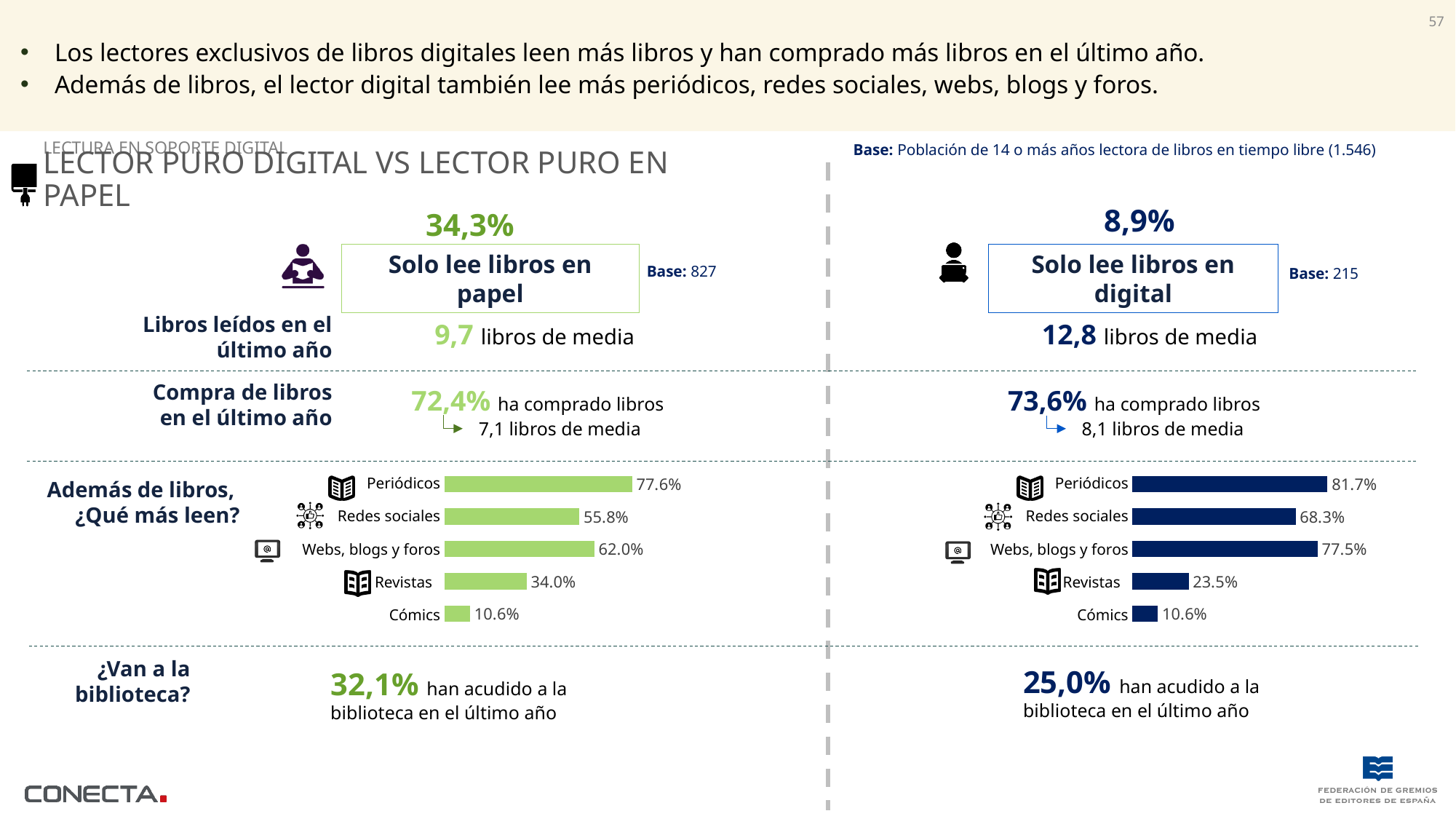
In the left-hand bar chart (Solo lee libros en papel), which category has the lowest value? Cómics In the left-hand bar chart (Solo lee libros en papel), what is the value for Revistas? 34.0% In the right-hand bar chart (Solo lee libros en digital), what is the value for Redes sociales? 68.3% In the left-hand bar chart (Solo lee libros en papel), what is the value for Periódicos? 77.6% Which is larger: Redes sociales in the left-hand chart (papel) or Redes sociales in the right-hand chart (digital)? Right-hand chart (digital) In the left-hand bar chart (Solo lee libros en papel), which is larger: Webs, blogs y foros or Redes sociales? Webs, blogs y foros In the left-hand bar chart (Solo lee libros en papel), what is the difference between Periódicos and Redes sociales? 21.8% In the right-hand bar chart (Solo lee libros en digital), what is the difference between Webs, blogs y foros and Revistas? 54.0% In the right-hand bar chart (Solo lee libros en digital), which category has the highest value? Periódicos In the right-hand bar chart (Solo lee libros en digital), what is the value for Webs, blogs y foros? 77.5% How many categories does the right-hand bar chart (Solo lee libros en digital) show? 5 What type of chart is used to show what readers read besides books on this slide? Bar chart